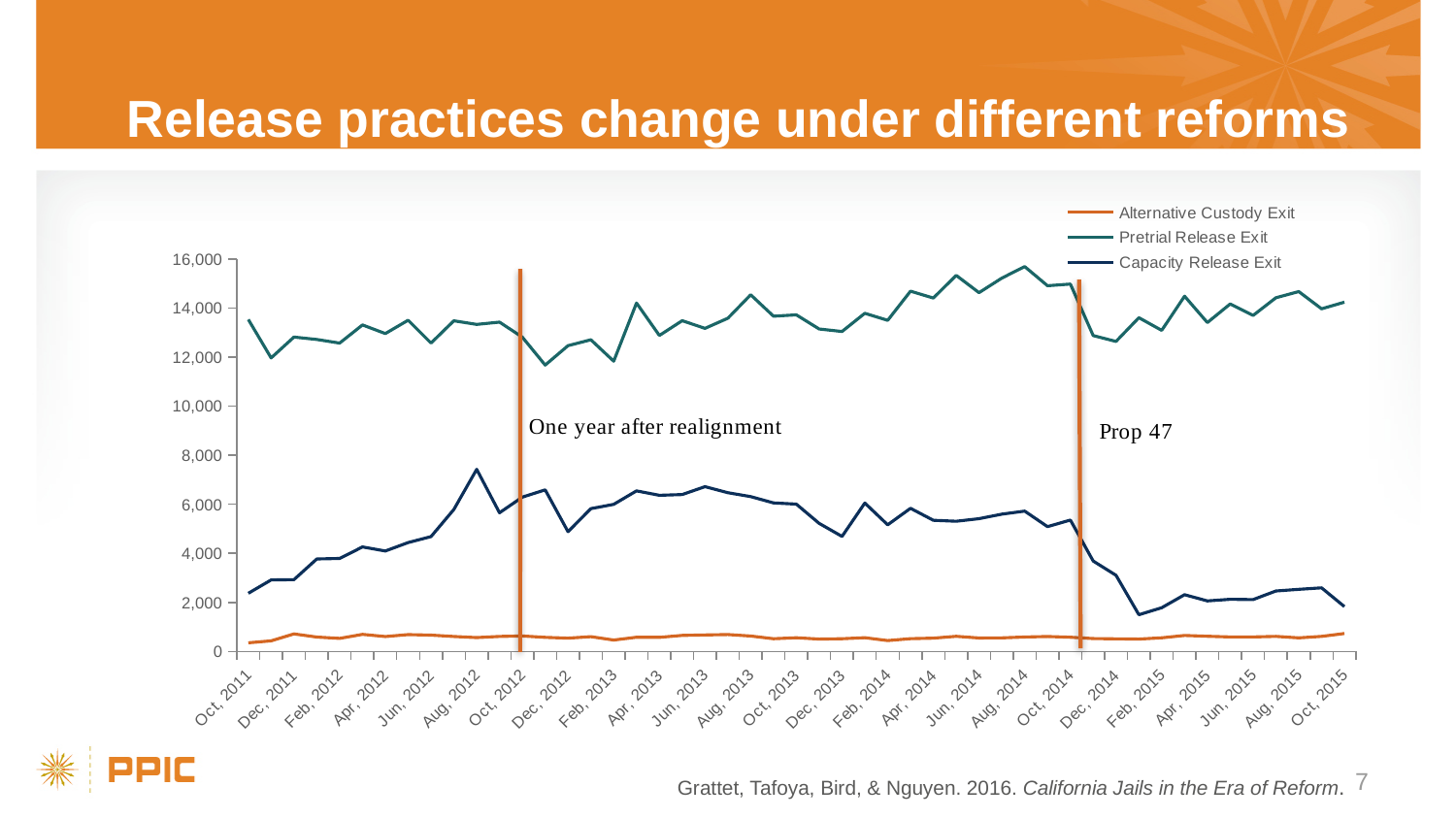
What is the title of the slide? Release practices change under different reforms In Oct, 2015, which is larger: Pretrial Release Exit or Capacity Release Exit? Pretrial Release Exit Is the value for Pretrial Release Exit in Oct, 2011 greater or less than 12,000? greater Is the value for Pretrial Release Exit in Aug, 2014 greater or less than 14,000? greater Which series has the highest values throughout the chart? Pretrial Release Exit How many series does the legend list? 3 What does the annotation at the first vertical orange line say? One year after realignment What kind of chart is shown on the slide? line chart Which series has the lowest values throughout the chart? Alternative Custody Exit Does the Capacity Release Exit series rise or fall after the Prop 47 line? fall Is the value for Capacity Release Exit in Aug, 2012 greater or less than 6,000? greater